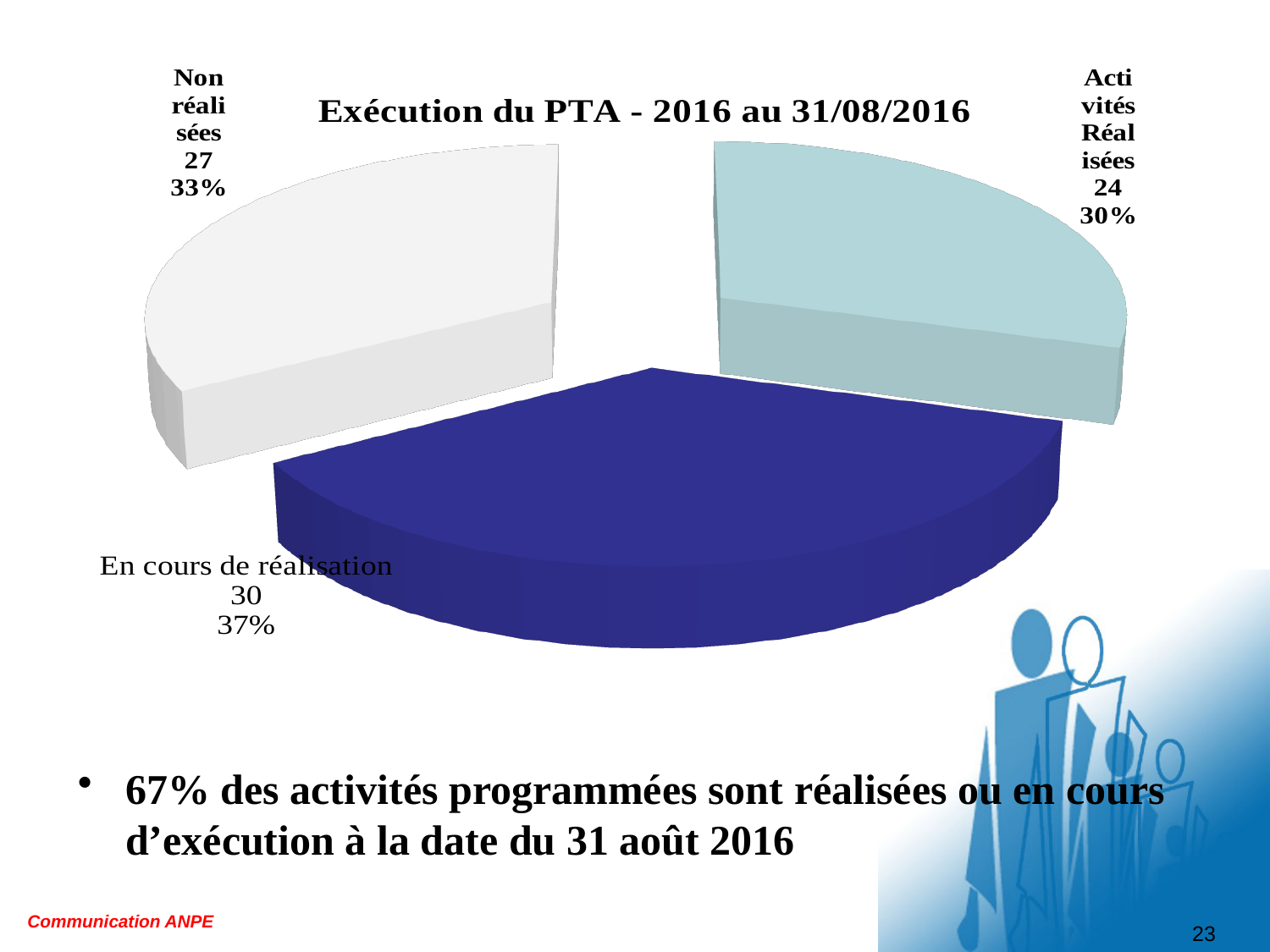
What is the value for 'En cours de réalisation'? 30 What share of the pie does 'En cours de réalisation' represent? 37% What is the title of the chart? Exécution du PTA - 2016 au 31/08/2016 What share of the pie does 'Activités Réalisées' represent? 30% What is the value for 'Non réalisées'? 27 What is the value for 'Activités Réalisées'? 24 What share of the pie does 'Non réalisées' represent? 33% What type of chart is shown on the slide? Pie chart What is the difference between the values for 'En cours de réalisation' and 'Activités Réalisées'? 6 Which category has the lowest value? Activités Réalisées How many slices does the pie chart have? 3 Which category has the highest value? En cours de réalisation